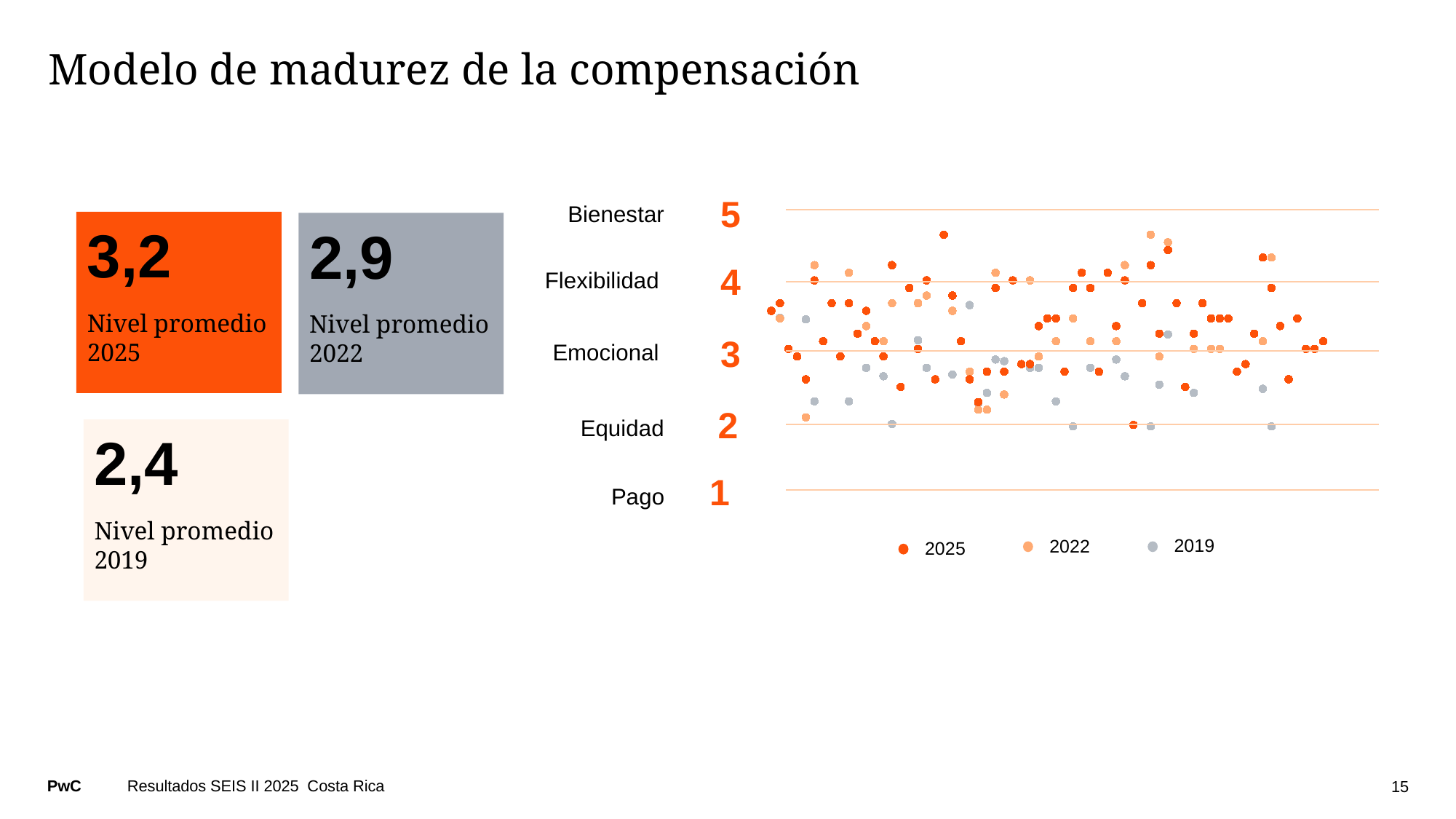
What kind of chart is shown on the slide? Scatter chart What is the average level (Nivel promedio) shown for 2022? 2,9 What is the average level (Nivel promedio) shown for 2025? 3,2 What is the difference between the average level for 2025 and the average level for 2019? 0,8 Is the average level for 2025 larger or smaller than the average level for 2022? Larger Which maturity level label corresponds to level 5 on the chart's vertical axis? Bienestar Which year has the lowest average level shown on the slide? 2019 How many series does the chart legend list? 3 Which years are listed in the chart legend? 2025, 2022, 2019 What is the average level (Nivel promedio) shown for 2019? 2,4 Do the average levels rise or fall from 2019 to 2025? Rise Which year has the highest average level shown on the slide? 2025